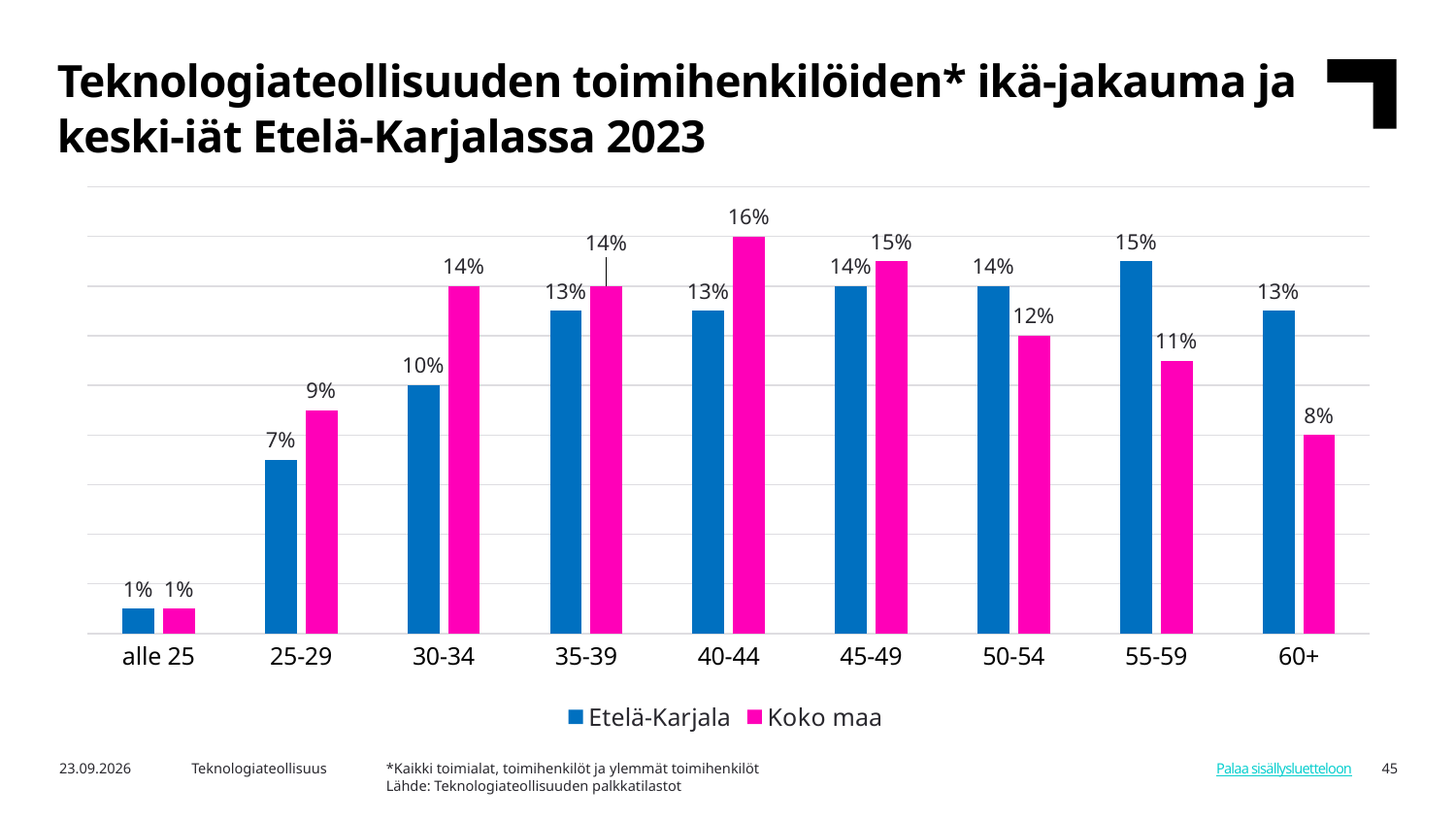
What is the value for Etelä-Karjala in the 30-34 age group? 10% Which age group has the highest value for Etelä-Karjala? 55-59 Which colour represents the Koko maa series? Pink In the 55-59 age group, which series has the larger value, Etelä-Karjala or Koko maa? Etelä-Karjala Which age group has the highest value for Koko maa? 40-44 What is the value for Koko maa in the 60+ age group? 8% What is the value for Koko maa in the 40-44 age group? 16% How many age groups are shown on the x axis? 9 What is the difference between the Koko maa and Etelä-Karjala values in the 30-34 age group? 4% Which age group has the lowest value for Koko maa? alle 25 How many series does the legend list? 2 What kind of chart is shown on the slide? Bar chart